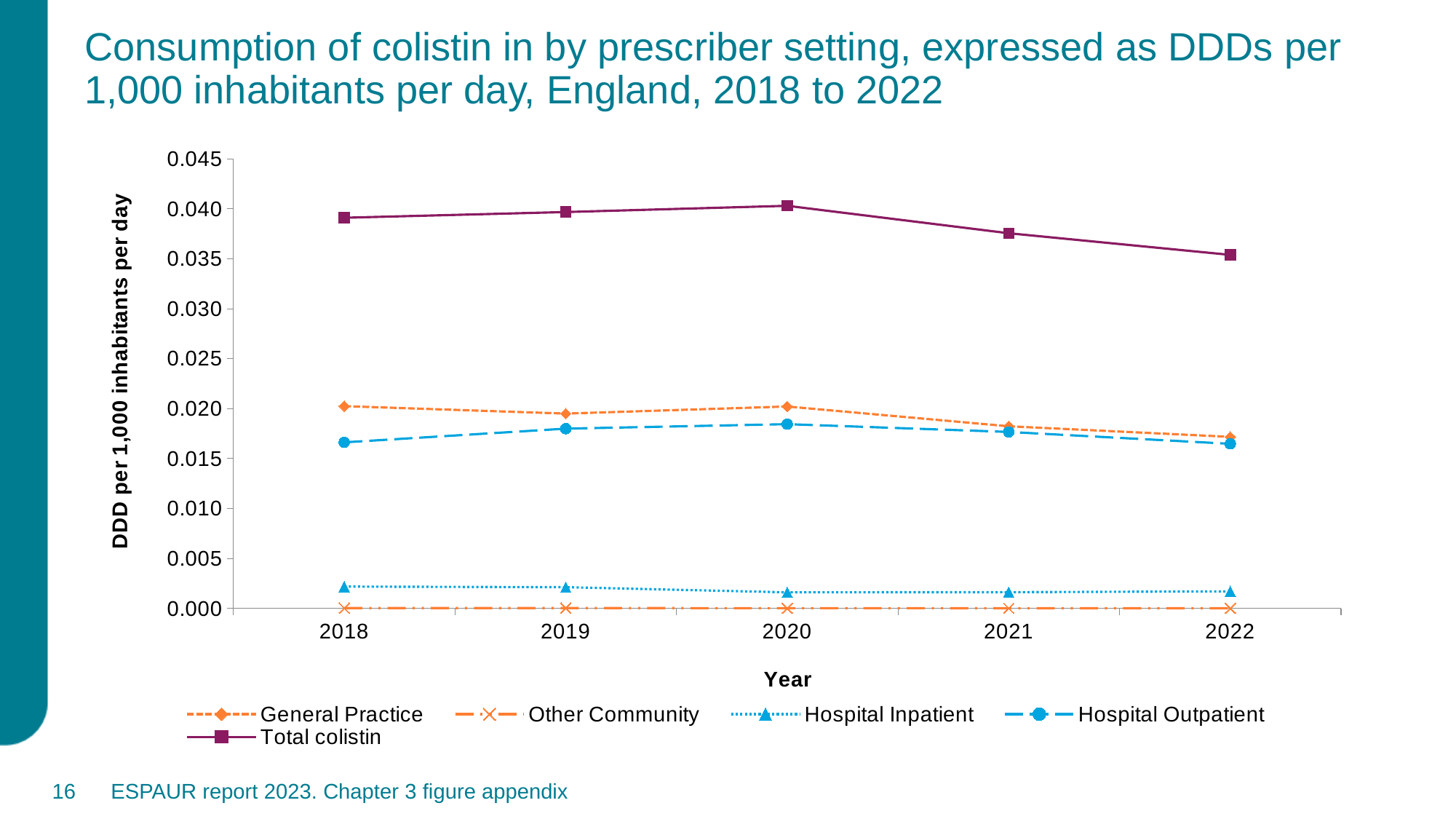
Does the Total colistin line rise or fall from 2020 to 2022? Fall Is the Total colistin value for 2022 greater or less than 0.040? less In which year is the Total colistin value lowest? 2022 How many years are plotted along the x axis? 5 What is the label on the y axis? DDD per 1,000 inhabitants per day Is the Hospital Inpatient value for 2020 greater or less than 0.005? less How many series does the legend list? 5 What kind of chart is shown on the slide? Line chart Which series has the lowest values across all years? Other Community In 2018, which is larger: General Practice or Hospital Outpatient? General Practice Is the Hospital Outpatient value for 2018 greater or less than 0.020? less Which series has the highest values across all years? Total colistin